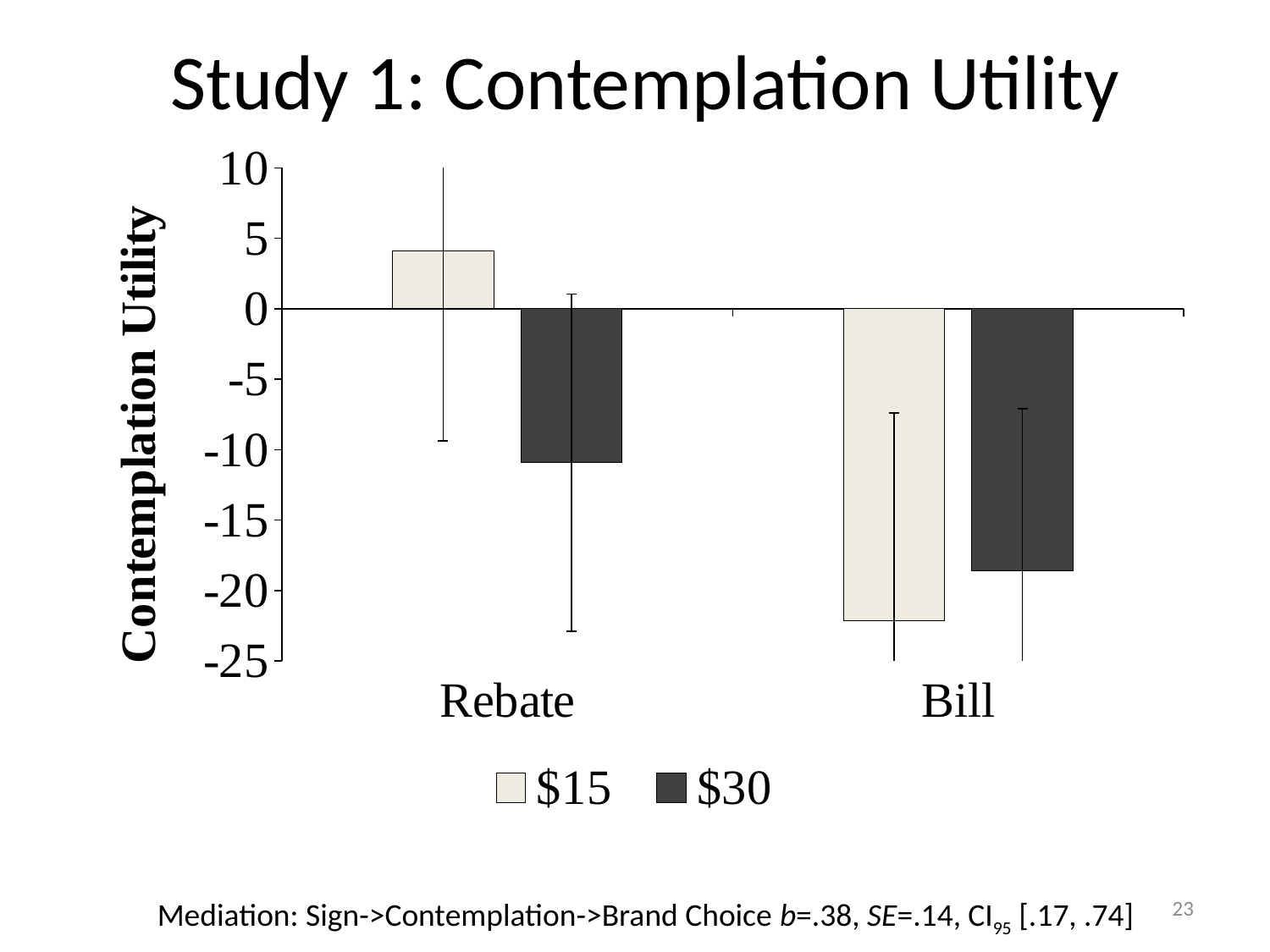
In the Rebate category, which series has the larger contemplation utility, $15 or $30? $15 Which category and series combination has the highest contemplation utility? Rebate, $15 What is the title of the y axis? Contemplation Utility What kind of chart is shown on the slide? bar chart How many series does the legend list? 2 Is the value for $15 in the Rebate category greater or less than 0? greater Which category and series combination has the lowest contemplation utility? Bill, $15 Is the value for $30 in the Rebate category greater or less than -5? less Is the value for $15 in the Bill category greater or less than -20? less How many categories are shown on the x axis? 2 What are the two series listed in the legend? $15 and $30